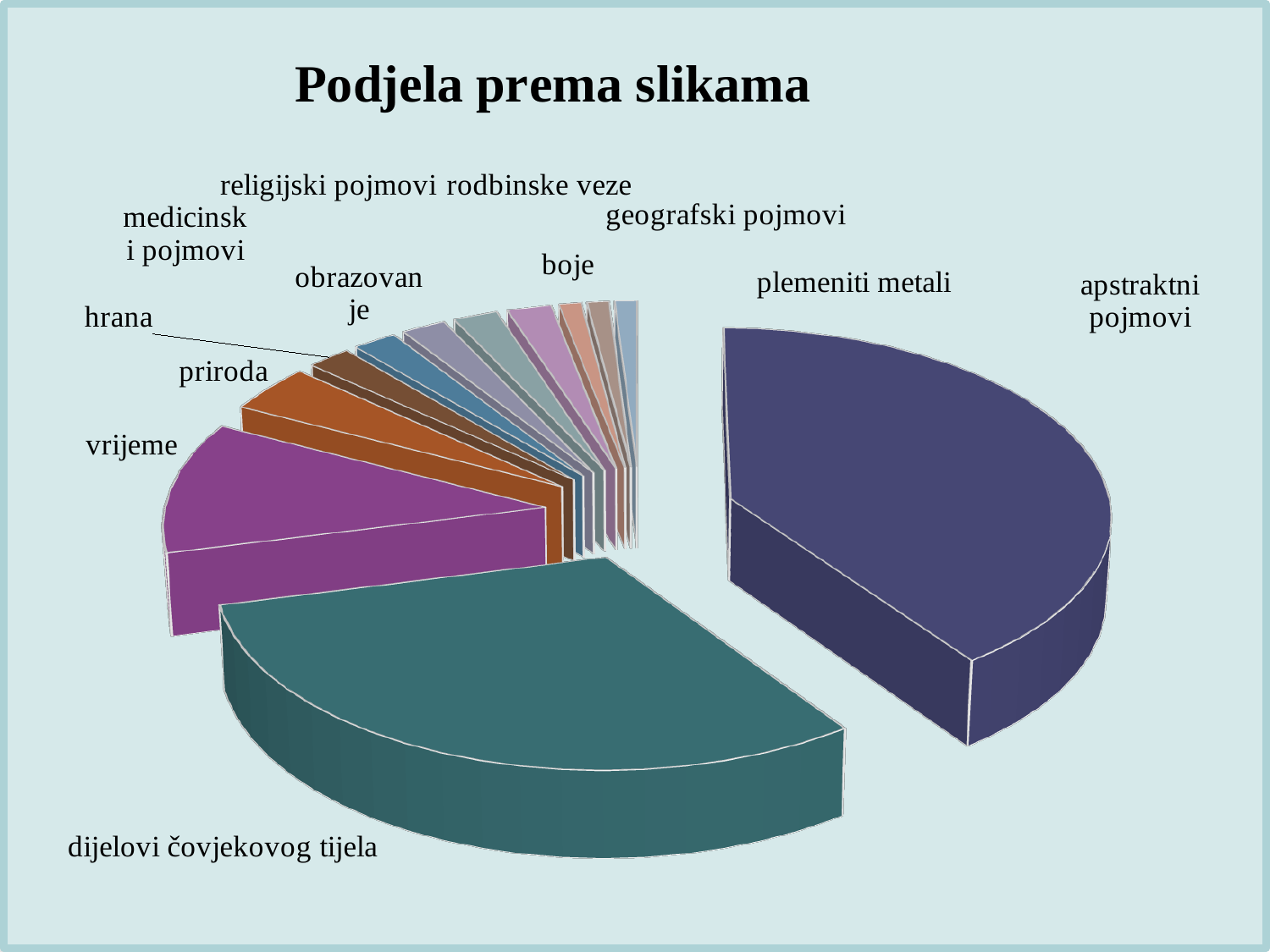
Which slice is larger, priroda or hrana? priroda Which slice is larger, dijelovi čovjekovog tijela or vrijeme? dijelovi čovjekovog tijela Which slice is larger, apstraktni pojmovi or priroda? apstraktni pojmovi How many categories (slices) does the pie chart have? 12 What colour is the slice labelled dijelovi čovjekovog tijela? teal What is the title of the chart? Podjela prema slikama What kind of chart is shown on the slide? pie chart